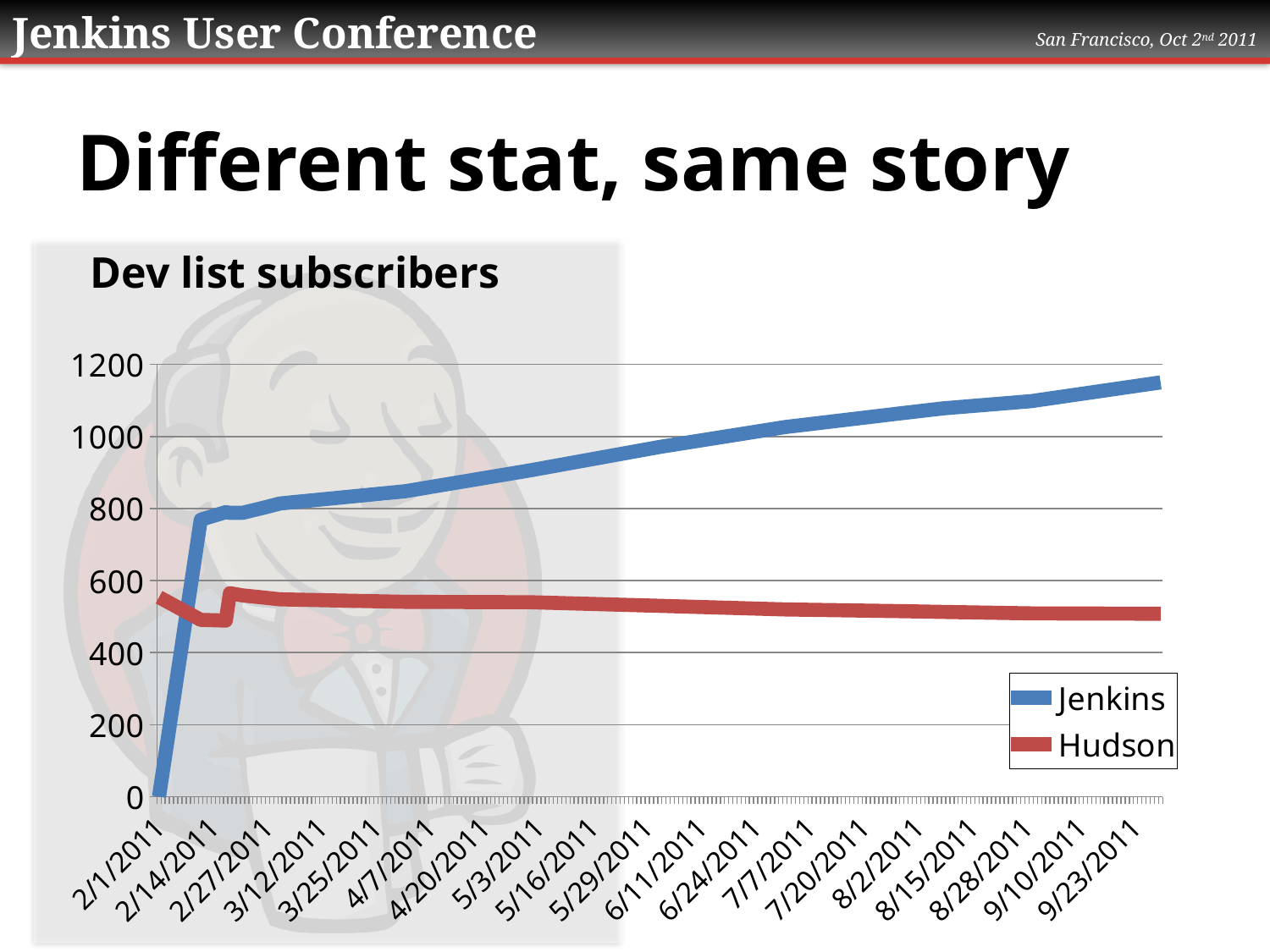
Is the value for Hudson at 9/23/2011 greater or less than 600? less Is the value for Jenkins at 9/23/2011 greater or less than 1000? greater Does the Jenkins line rise or fall from 2/14/2011 to 9/23/2011? rise How many series does the legend list? 2 What kind of chart is shown on the slide? line chart At 9/23/2011, which series is higher, Jenkins or Hudson? Jenkins Which colour is used for the Hudson series? red Is the value for Hudson at 2/1/2011 greater or less than 400? greater Does the Hudson line rise or fall from 2/27/2011 to 9/23/2011? fall What is the title of the chart? Dev list subscribers At 2/1/2011, which series is higher, Jenkins or Hudson? Hudson